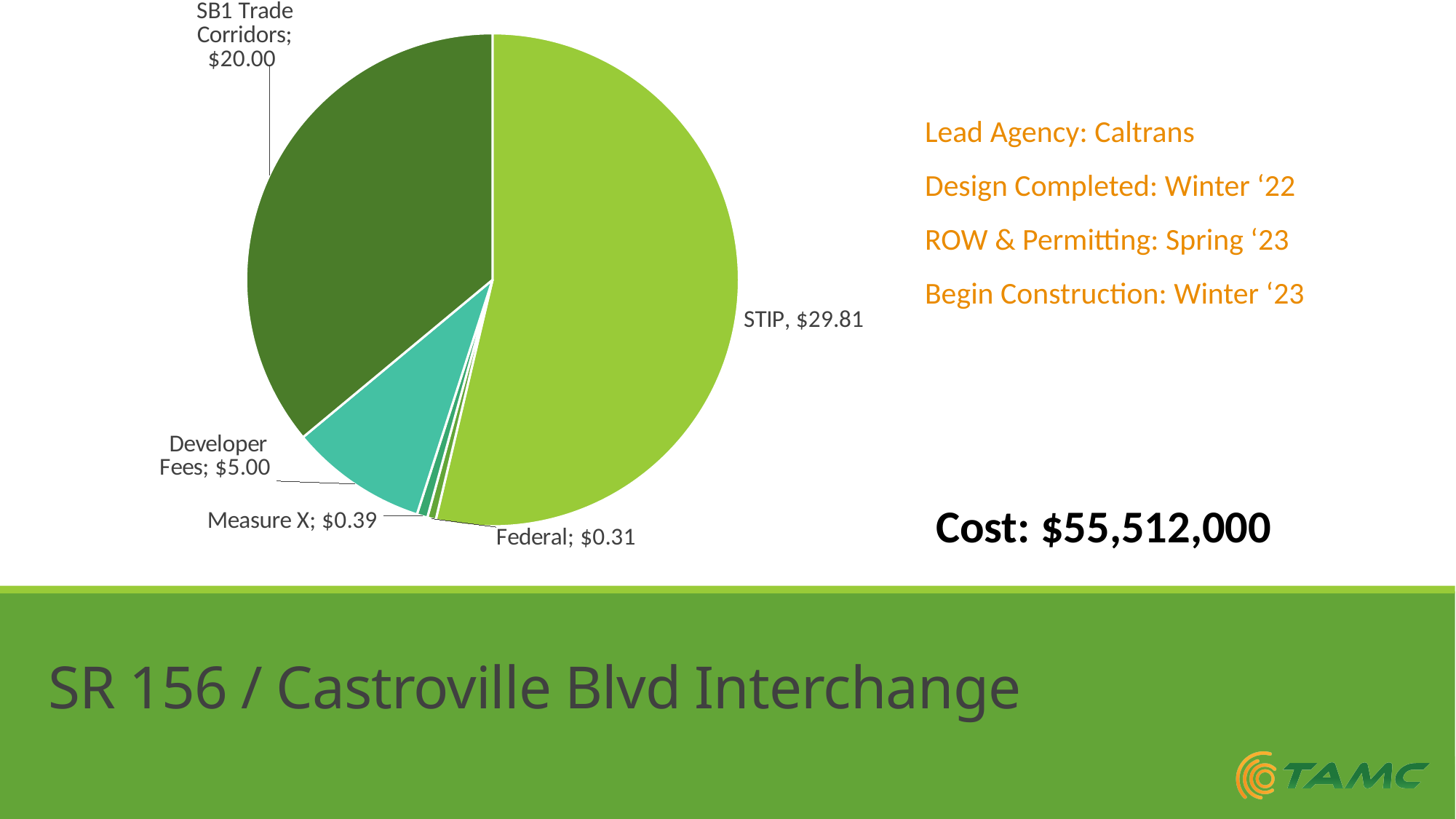
What type of chart is shown on the slide? Pie chart What is the value for Measure X in the pie chart? $0.39 How many slices does the pie chart have? 5 Which slice of the pie chart is the largest? STIP What is the value for Federal in the pie chart? $0.31 What is the value for Developer Fees in the pie chart? $5.00 What is the value for STIP in the pie chart? $29.81 Which is larger, the value for Measure X or the value for Federal? Measure X What is the value for SB1 Trade Corridors in the pie chart? $20.00 Which slice of the pie chart is the smallest? Federal What is the difference between the STIP value and the SB1 Trade Corridors value? $9.81 What is the difference between the Developer Fees value and the Measure X value? $4.61